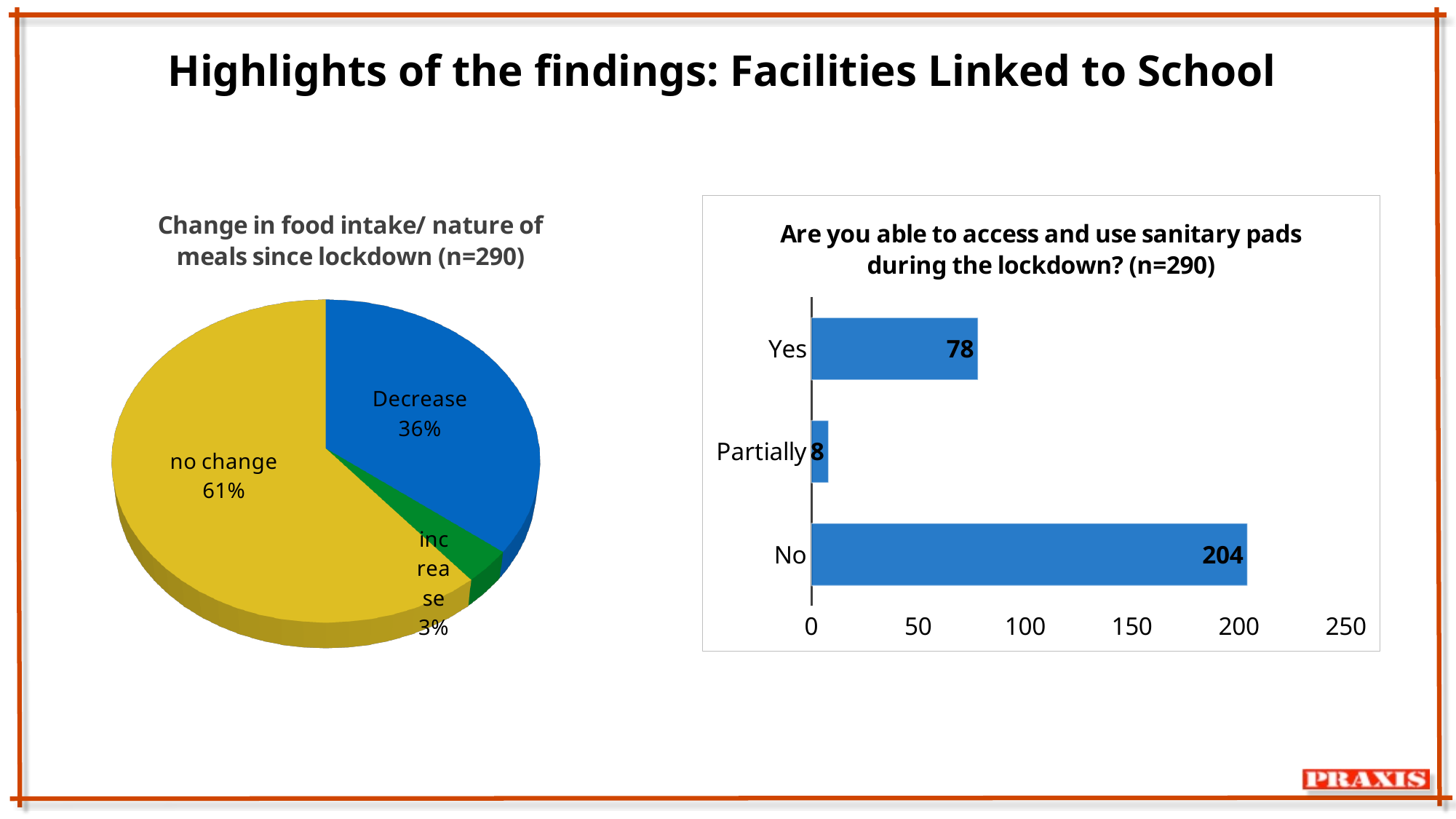
In the pie chart 'Change in food intake/ nature of meals since lockdown (n=290)', which category has the largest slice? no change What kind of chart is 'Are you able to access and use sanitary pads during the lockdown? (n=290)'? Bar chart In the pie chart 'Change in food intake/ nature of meals since lockdown (n=290)', what share of respondents reported no change? 61% In the chart 'Are you able to access and use sanitary pads during the lockdown? (n=290)', what is the value for 'Partially'? 8 In the pie chart 'Change in food intake/ nature of meals since lockdown (n=290)', what percentage reported a decrease? 36% In the chart 'Are you able to access and use sanitary pads during the lockdown? (n=290)', what is the value for 'Yes'? 78 In the chart 'Are you able to access and use sanitary pads during the lockdown? (n=290)', what is the difference between the 'No' and 'Yes' values? 126 In the chart 'Are you able to access and use sanitary pads during the lockdown? (n=290)', is the value for 'No' greater or less than 200? greater In the pie chart 'Change in food intake/ nature of meals since lockdown (n=290)', how many slices are there? 3 In the pie chart 'Change in food intake/ nature of meals since lockdown (n=290)', which category has the smallest slice? increase In the chart 'Are you able to access and use sanitary pads during the lockdown? (n=290)', what is the value for 'No'? 204 In the pie chart 'Change in food intake/ nature of meals since lockdown (n=290)', what is the difference in percentage points between 'no change' and 'Decrease'? 25 percentage points